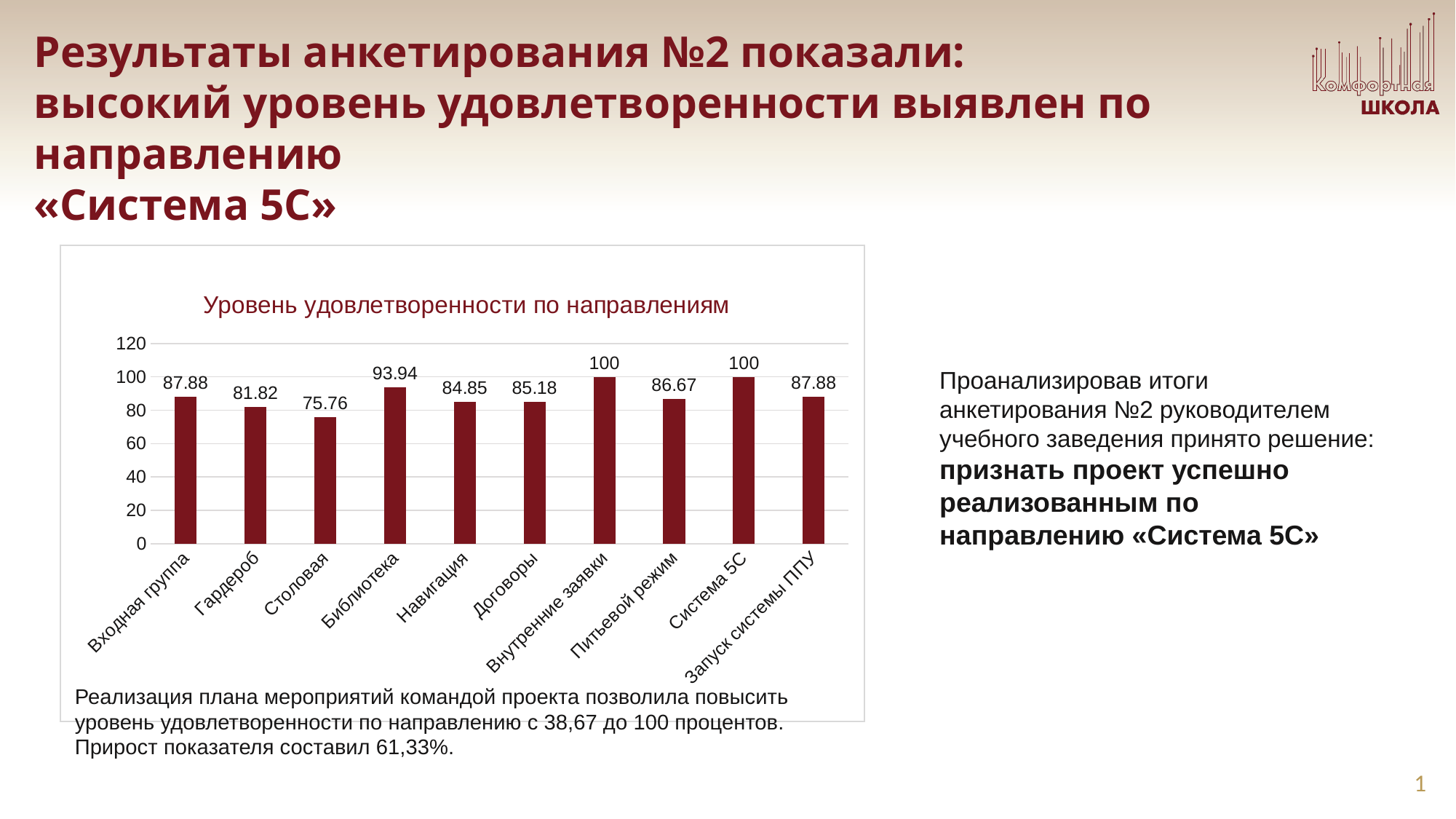
How many categories are shown in the chart? 10 What is the value for Столовая? 75.76 Which is larger, the value for Навигация or the value for Договоры? Договоры What is the value for Библиотека? 93.94 What is the title of the chart? Уровень удовлетворенности по направлениям What is the highest value shown in the chart? 100 What type of chart is shown on the slide? bar chart Is the value for Входная группа greater or less than 80? greater What is the value for Система 5С? 100 What is the value for Питьевой режим? 86.67 Which category has the lowest value? Столовая What is the difference between the values for Библиотека and Гардероб? 12.12